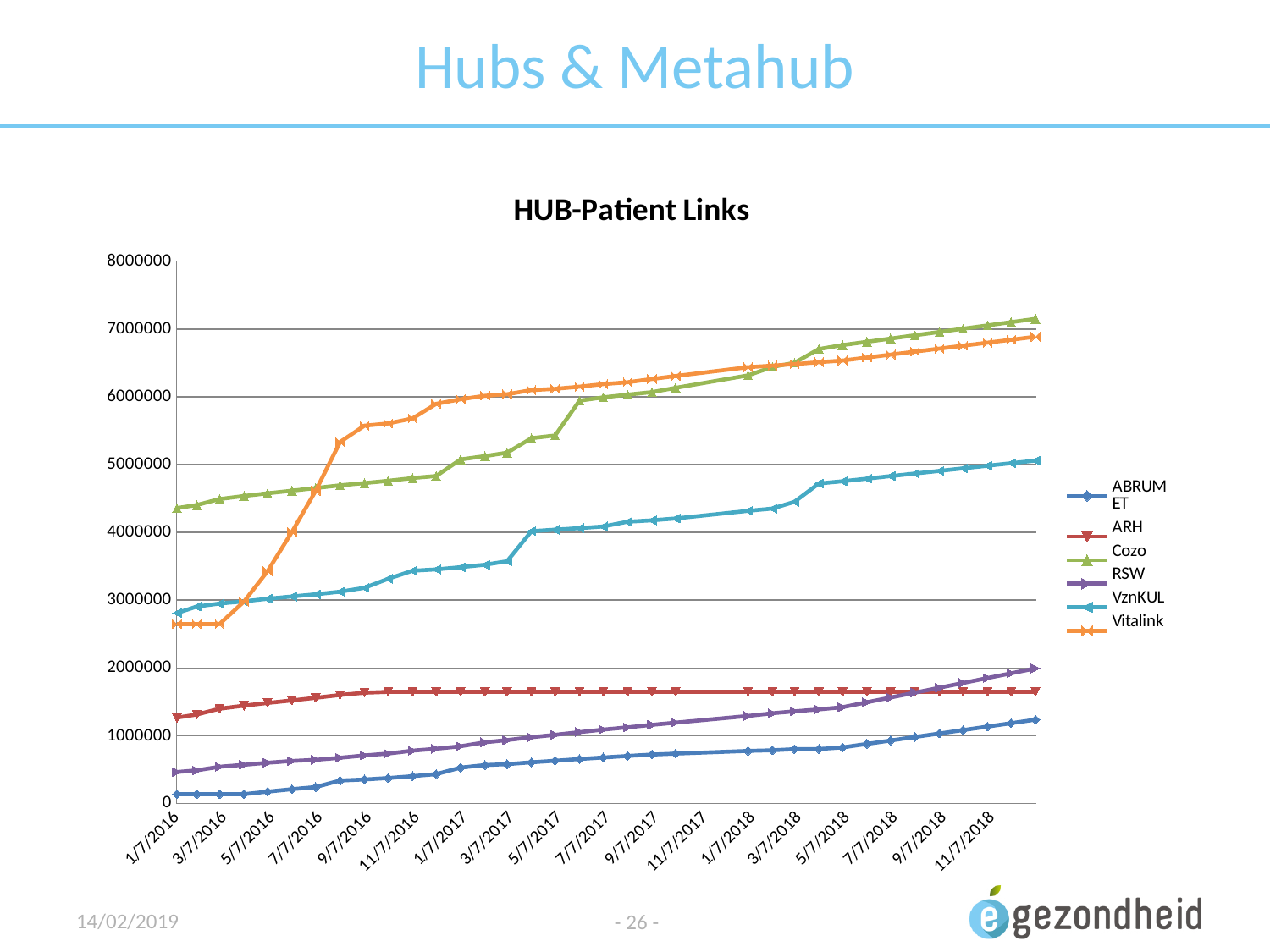
What is the title of the chart? HUB-Patient Links Is the value for VznKUL at 1/7/2016 greater or less than 3000000? less Is the value for Vitalink at 1/7/2016 greater or less than 3000000? less At 1/7/2016, which series has the larger value, Cozo or Vitalink? Cozo Which series has the lowest values across the whole chart? ABRUMET What kind of chart is shown on the slide? line chart Is the value for Cozo at 1/7/2016 greater or less than 4000000? greater Do the values for ABRUMET rise or fall over time along the x axis? rise Which series has the highest value at the last date on the chart? Cozo How many series does the legend list? 6 At 1/7/2016, which series has the larger value, ARH or RSW? ARH